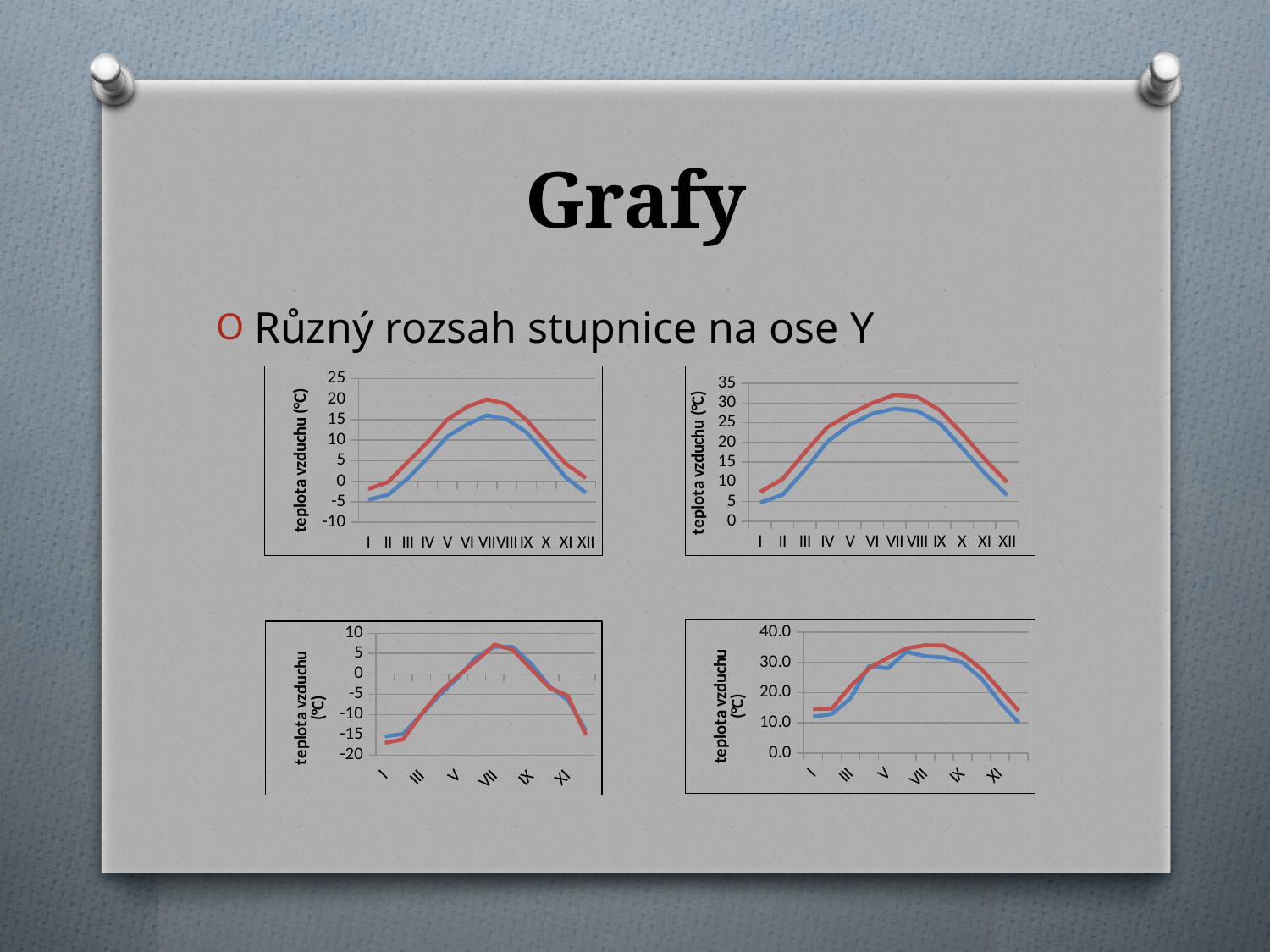
In the top-left chart, is the value of the blue line at I greater or less than 0? less In the bottom-right chart, is the value of the blue line at the last month greater or less than 20.0? less In the top-left chart, is the value of the red line at VII greater or less than 15? greater In the top-right chart, do the values rise or fall from I to VII? rise In the top-left chart, at which month does the red line reach its highest value? VII What is the lowest value shown on the y axis of the bottom-left chart? -20 How many categories are shown on the x axis of the top-left chart? 12 What is the label on the y axis of the top-right chart? teplota vzduchu (°C) How many lines are plotted in the top-right chart? 2 What kind of chart is the top-left chart on the slide? line chart